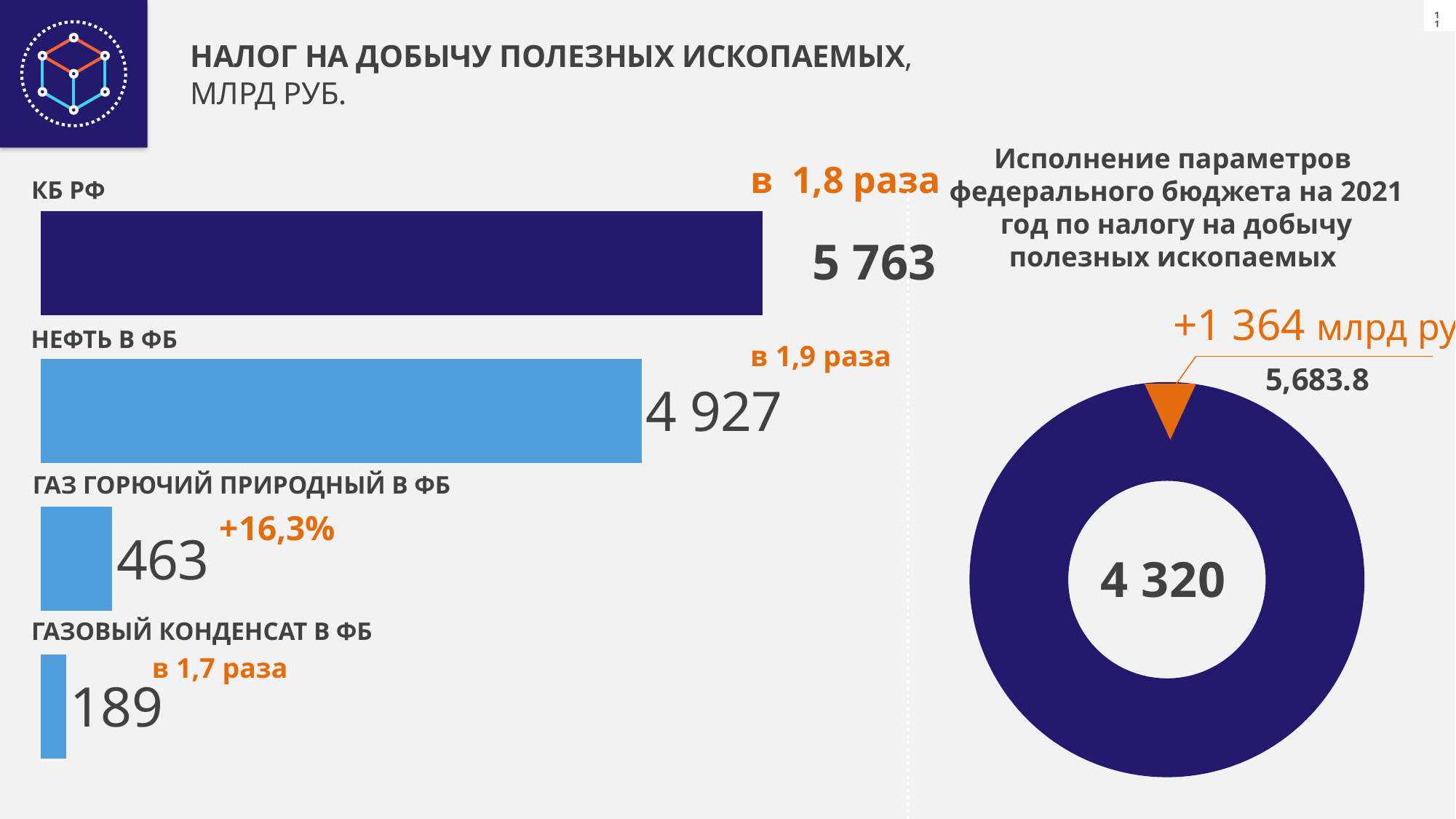
On the bar chart on the left, what is the value for ГАЗОВЫЙ КОНДЕНСАТ В ФБ? 189 How many categories does the bar chart on the left show? 4 On the bar chart on the left, what is the difference between the values for КБ РФ and НЕФТЬ В ФБ? 836 On the bar chart on the left, what is the value for ГАЗ ГОРЮЧИЙ ПРИРОДНЫЙ В ФБ? 463 What kind of chart is shown on the right of the slide? donut chart On the bar chart on the left, which category has the lowest value? ГАЗОВЫЙ КОНДЕНСАТ В ФБ On the bar chart on the left, which is larger: ГАЗ ГОРЮЧИЙ ПРИРОДНЫЙ В ФБ or ГАЗОВЫЙ КОНДЕНСАТ В ФБ? ГАЗ ГОРЮЧИЙ ПРИРОДНЫЙ В ФБ On the bar chart on the left, what is the value for НЕФТЬ В ФБ? 4 927 On the bar chart on the left, which category has the highest value? КБ РФ On the donut chart on the right, what value is shown in the centre? 4 320 What kind of chart is shown on the left of the slide? bar chart On the bar chart on the left, what is the value for КБ РФ? 5 763